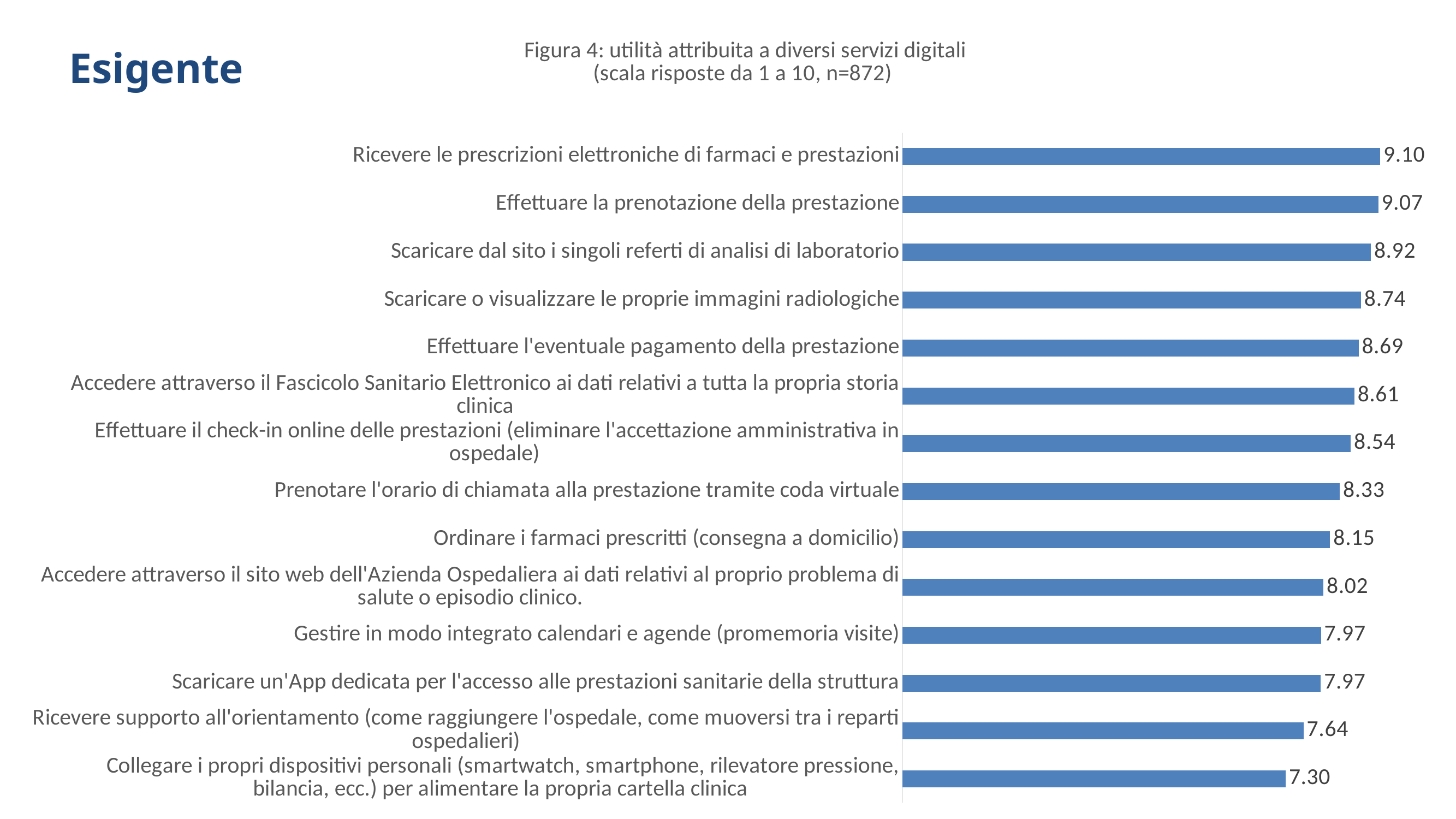
What is the title of the chart? Figura 4: utilità attribuita a diversi servizi digitali (scala risposte da 1 a 10, n=872) What type of chart is shown on the slide? Bar chart How many services are shown in the chart? 14 What value is shown for "Ricevere supporto all'orientamento (come raggiungere l'ospedale, come muoversi tra i reparti ospedalieri)"? 7.64 What is the difference between the value for "Ricevere le prescrizioni elettroniche di farmaci e prestazioni" and the value for "Collegare i propri dispositivi personali (smartwatch, smartphone, rilevatore pressione, bilancia, ecc.) per alimentare la propria cartella clinica"? 1.80 Which service has the highest value in the chart? Ricevere le prescrizioni elettroniche di farmaci e prestazioni What value is shown for "Effettuare la prenotazione della prestazione"? 9.07 What is the difference between the value for "Scaricare dal sito i singoli referti di analisi di laboratorio" and the value for "Prenotare l'orario di chiamata alla prestazione tramite coda virtuale"? 0.59 What value is shown for "Ordinare i farmaci prescritti (consegna a domicilio)"? 8.15 What value is shown for "Scaricare o visualizzare le proprie immagini radiologiche"? 8.74 Which has a higher value: "Effettuare l'eventuale pagamento della prestazione" or "Effettuare il check-in online delle prestazioni (eliminare l'accettazione amministrativa in ospedale)"? Effettuare l'eventuale pagamento della prestazione Which service has the lowest value in the chart? Collegare i propri dispositivi personali (smartwatch, smartphone, rilevatore pressione, bilancia, ecc.) per alimentare la propria cartella clinica